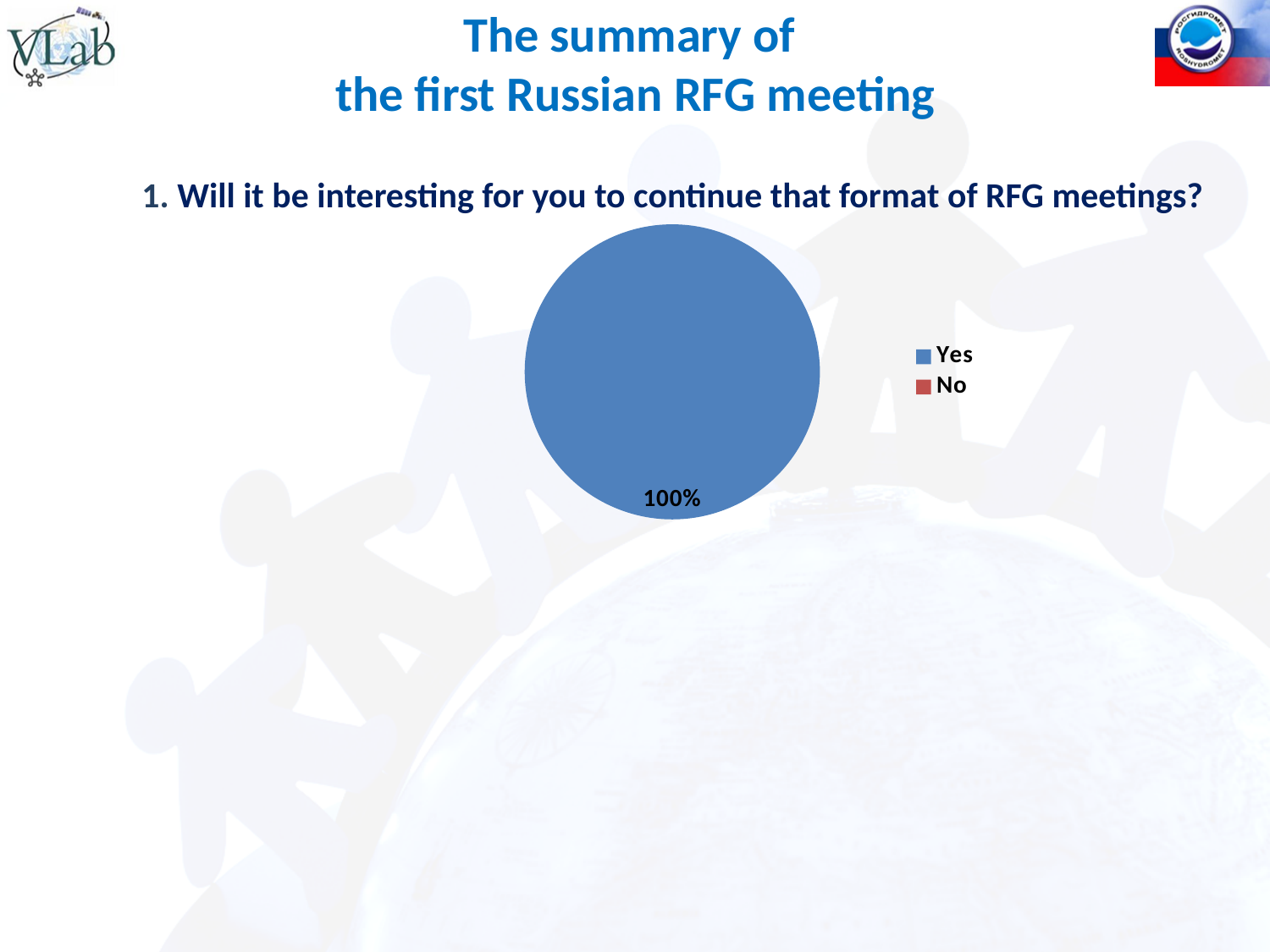
Which category has the largest share of the pie? Yes Which category has the smallest share of the pie? No What is the value printed as a data label on the pie? 100% Which is larger, the share for Yes or the share for No? Yes How many entries does the legend list? 2 What colour is used for No in the legend? red What share of the pie does the Yes slice take? 100% What colour is the Yes slice in the legend? blue What kind of chart is shown on the slide? pie chart